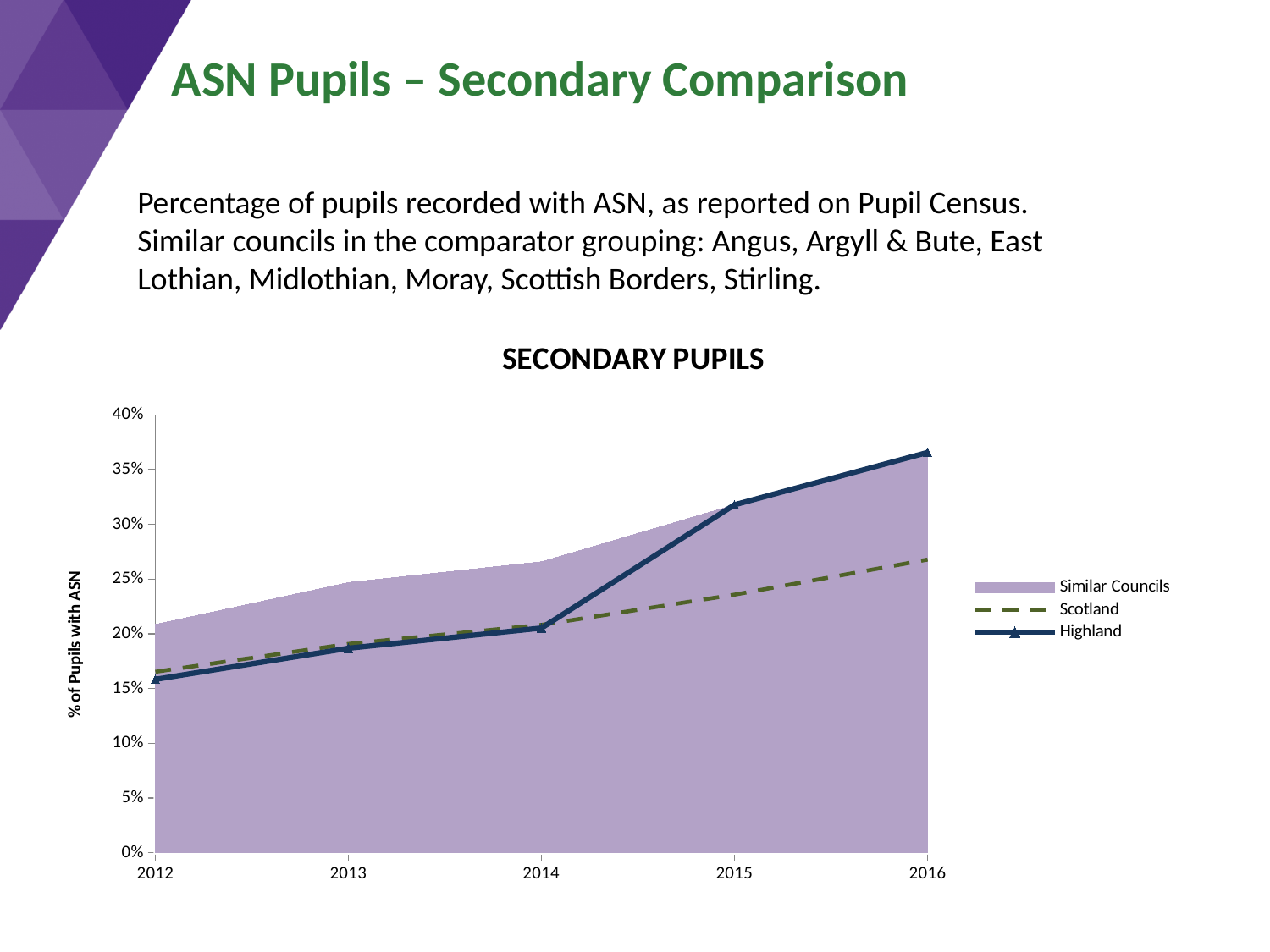
Is the Scotland value for 2016 greater or less than 30%? less What kind of chart is used to plot the Highland series? line chart In 2016, which is larger: the Highland value or the Scotland value? Highland Is the Highland value for 2012 greater or less than 20%? less Is the Highland value for 2016 greater or less than 35%? greater How many series does the chart legend list? 3 Which series are listed in the chart legend? Similar Councils, Scotland, Highland Does the Highland series rise or fall from 2012 to 2016? rise In which year is the Highland value lowest? 2012 In which year is the Highland value highest? 2016 How many years are shown on the x axis of the chart? 5 What is the title of the chart? SECONDARY PUPILS